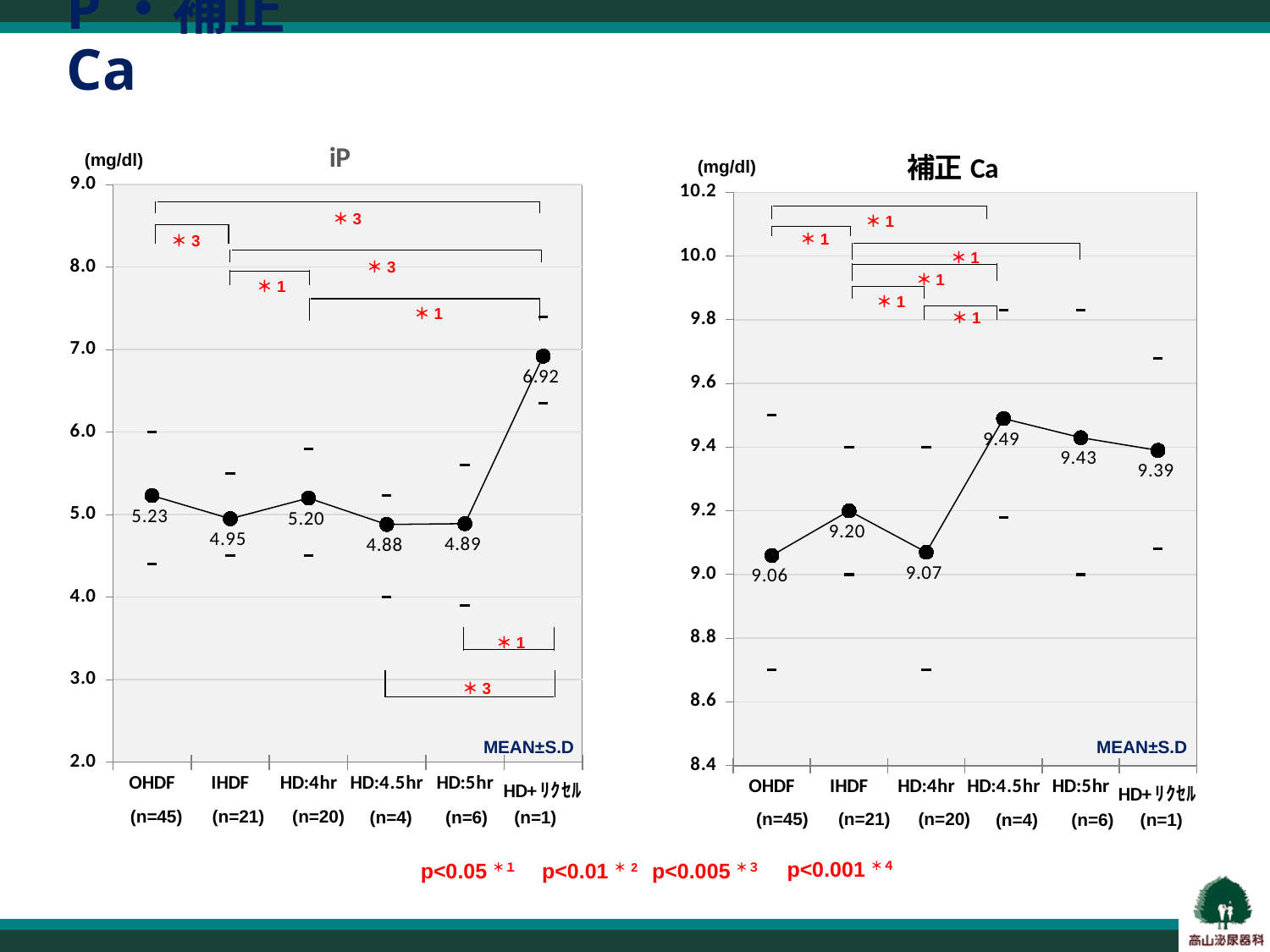
In the 補正 Ca chart, which has the larger mean value, IHDF or HD:5hr? HD:5hr In the iP chart, which category has the highest mean value? HD+リクセル In the 補正 Ca chart, what is the difference between the mean values for HD:4.5hr and HD:4hr? 0.42 In the iP chart, is the mean value for HD:4.5hr greater or less than 5.0? less In the iP chart, what is the mean value for OHDF? 5.23 In the iP chart, what is the difference between the mean values for HD+リクセル and HD:5hr? 2.03 In the 補正 Ca chart, what is the mean value for HD:4.5hr? 9.49 In the iP chart, what is the mean value for HD+リクセル? 6.92 In the 補正 Ca chart, which category has the lowest mean value? OHDF In the 補正 Ca chart, what is the mean value for IHDF? 9.20 How many categories are plotted along the x axis of the 補正 Ca chart? 6 What kind of chart is the iP chart? line chart